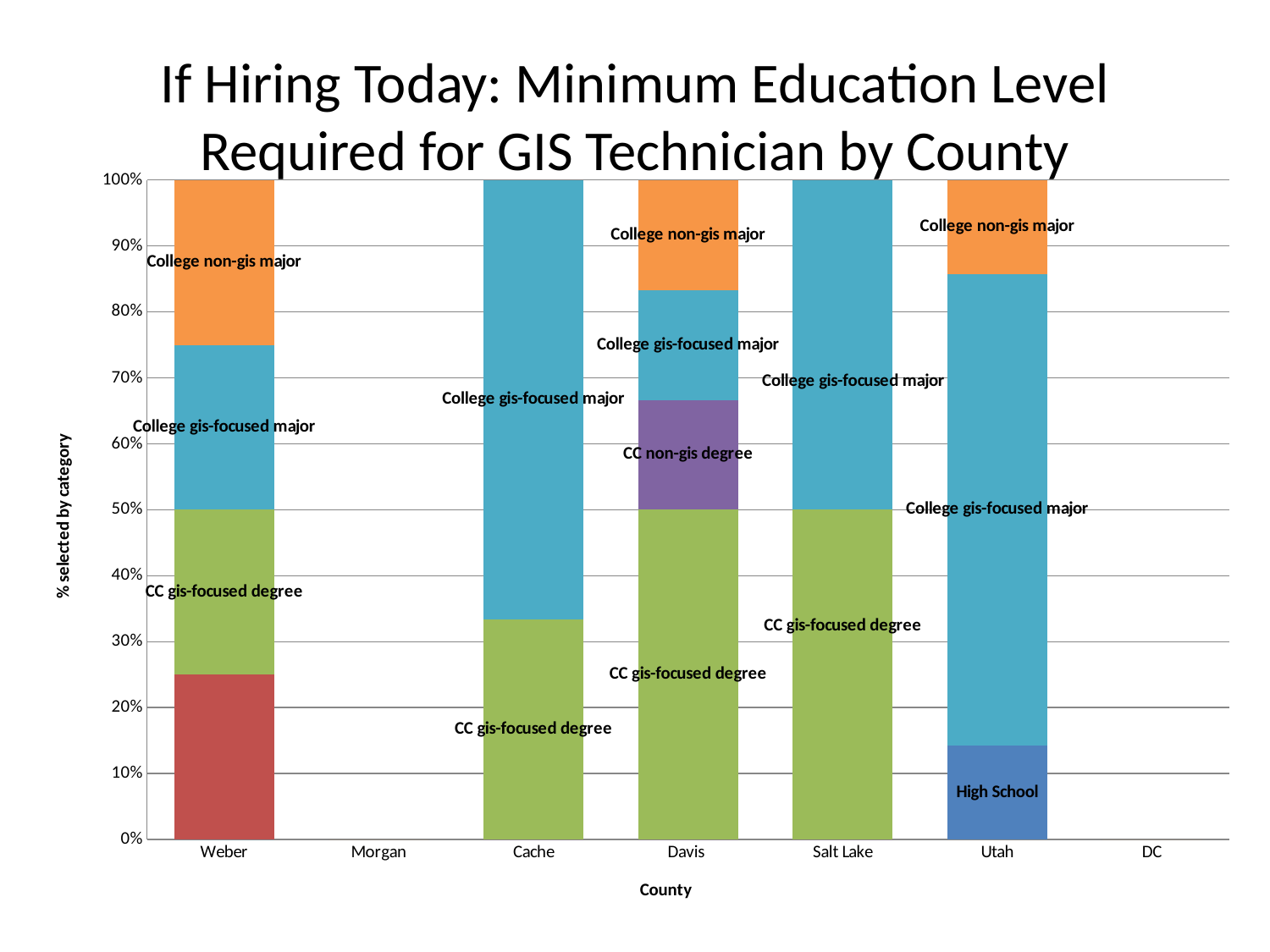
What is the title of the chart? If Hiring Today: Minimum Education Level Required for GIS Technician by County Is the High School share for Utah greater or less than 20%? less Which county is the only one with a High School segment? Utah Which county is the only one with a CC non-gis degree segment? Davis Which has the larger College non-gis major share, Weber or Davis? Weber How many counties are listed along the x axis? 7 Is the College gis-focused major share for Utah greater or less than 60%? greater Is the College non-gis major share for Davis greater or less than 20%? less Which has the larger College gis-focused major share, Cache or Salt Lake? Cache Which counties have no bar plotted? Morgan and DC What kind of chart is shown on the slide? Stacked bar chart